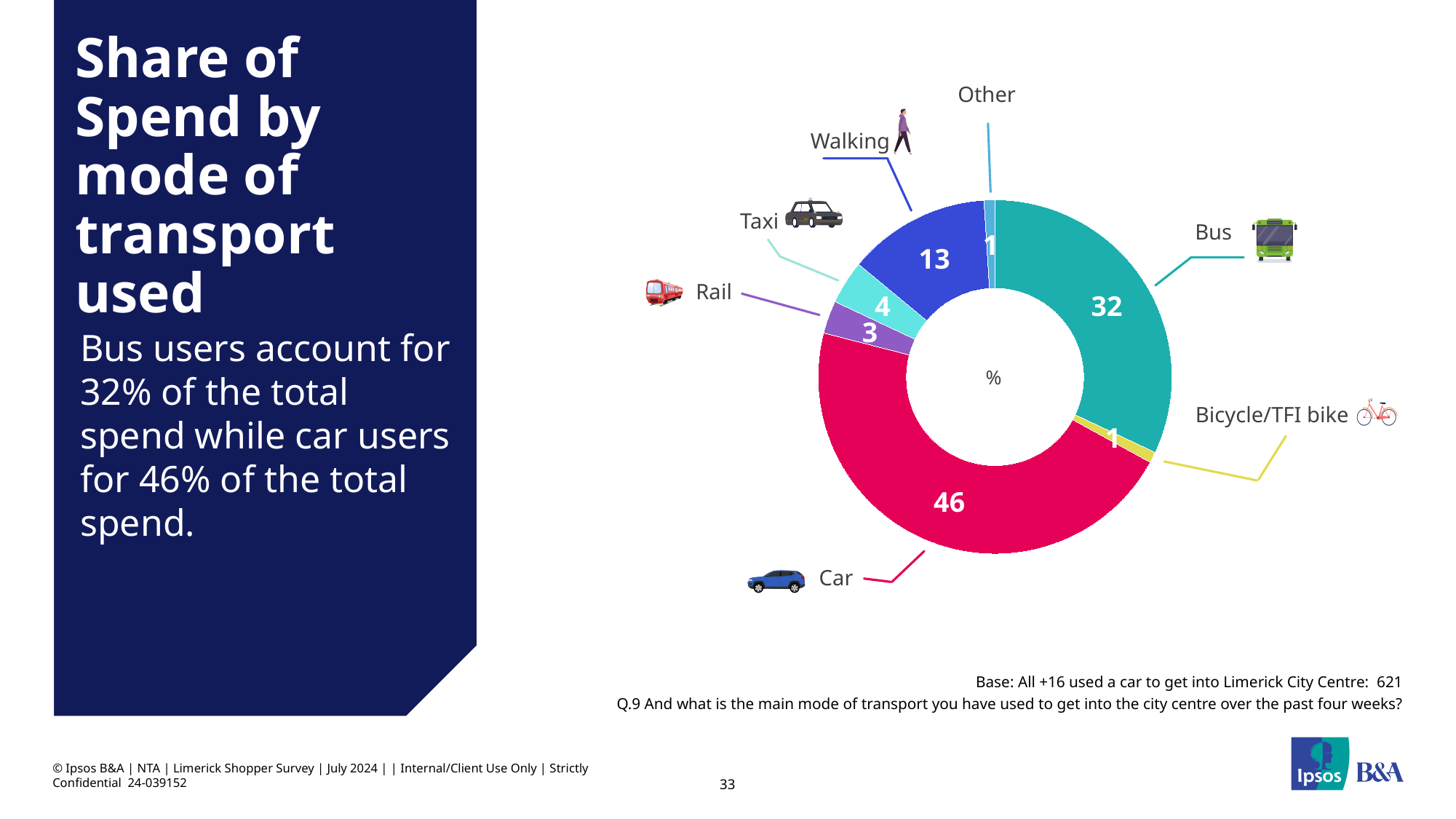
What is the difference between the values for Car and Bus? 14 What is the value shown for Bicycle/TFI bike in the donut chart? 1 What is the value shown for Taxi in the donut chart? 4 What share of the total spend does Car account for? 46% Which has a larger value, Bus or Walking? Bus Which mode of transport has the largest share of spend in the chart? Car Which has a larger value, Walking or Taxi? Walking What is the value shown for Rail in the donut chart? 3 What is the value shown for Bus in the donut chart? 32 What is the value shown for Walking in the donut chart? 13 What kind of chart is shown on the slide? Donut (pie) chart How many modes of transport are shown in the chart? 7